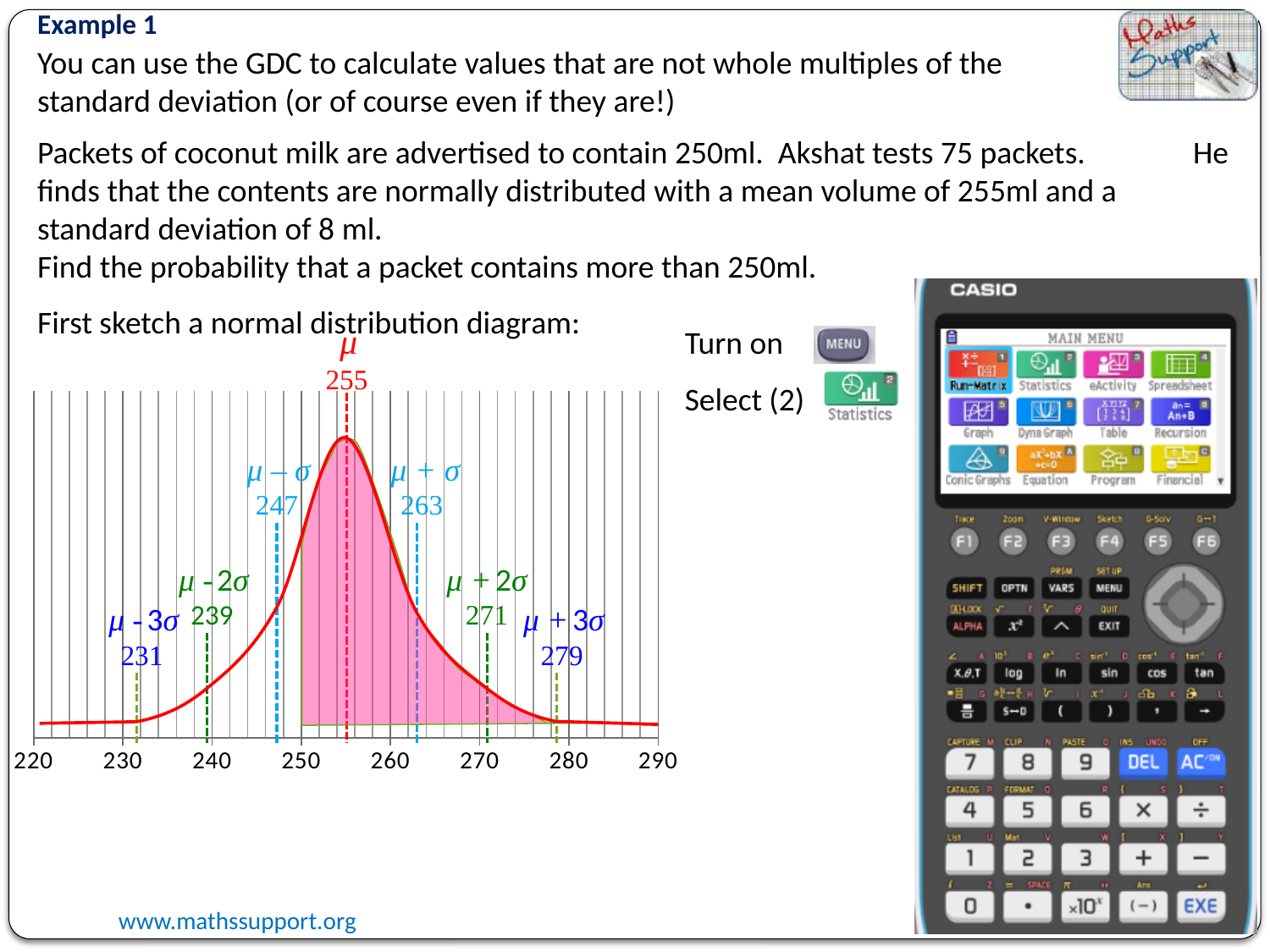
What is the difference between the values labelled at μ + 3σ and μ − 3σ? 48 What is the highest value shown on the x axis of the diagram? 290 What value is labelled at μ + σ on the diagram? 263 What is the lowest value shown on the x axis of the diagram? 220 What value is labelled at μ + 2σ on the diagram? 271 Is the value labelled at μ − 2σ greater or less than 240? less At what x value does the pink shaded region under the curve begin? 250 What is the difference between the values labelled at μ + σ and μ − σ? 16 What value is labelled at μ − 3σ on the diagram? 231 What value is labelled at μ − σ on the diagram? 247 What value is labelled at the mean μ on the normal distribution diagram? 255 Which is larger, the value labelled at μ + 2σ or the value labelled at μ + 3σ? μ + 3σ